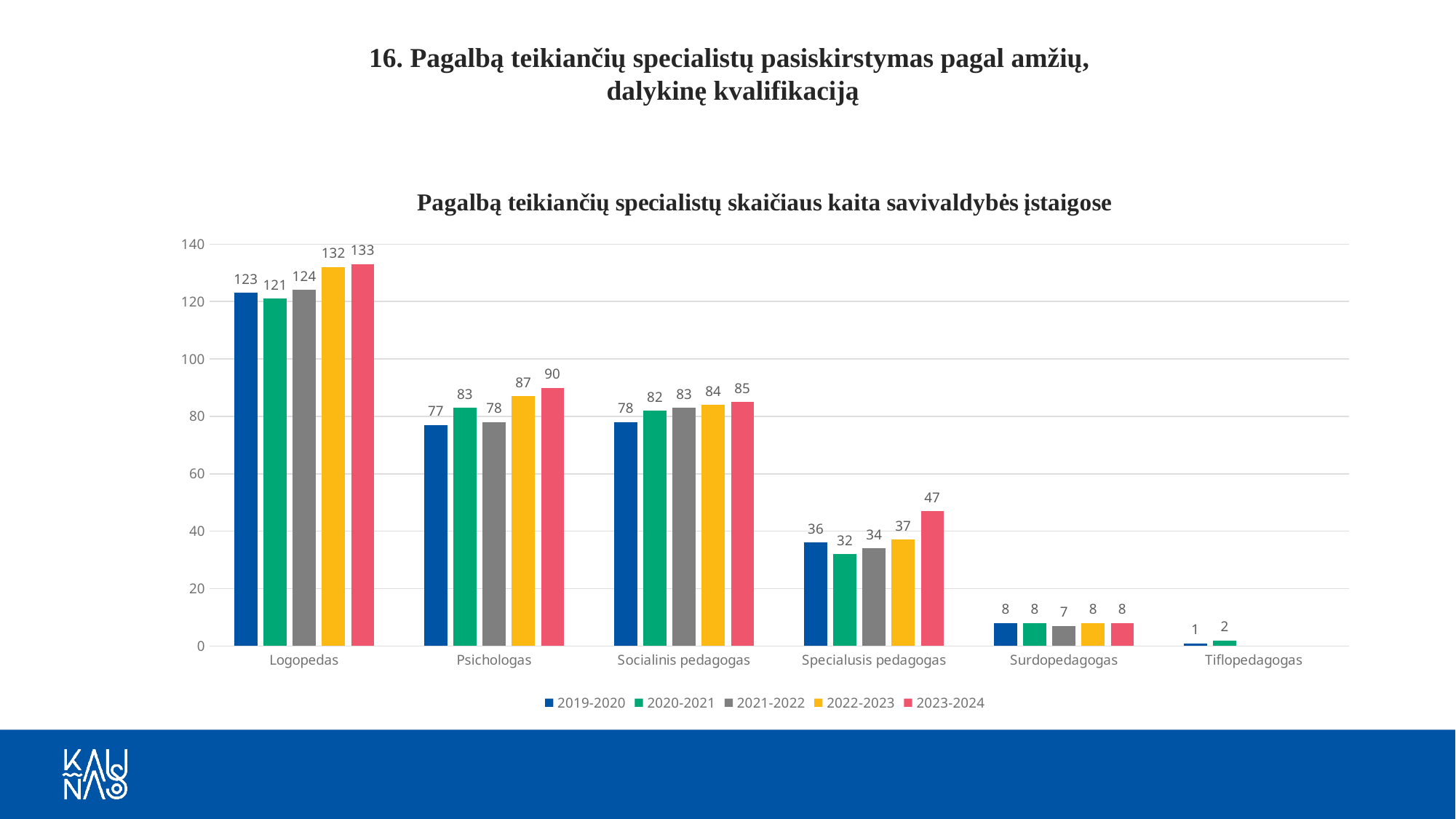
What is the difference between the 2023-2024 and 2019-2020 values for Specialusis pedagogas? 11 What kind of chart is shown on the slide? Bar chart What is the value for Logopedas in the 2023-2024 series? 133 What is the value for Specialusis pedagogas in the 2022-2023 series? 37 Do the values for Socialinis pedagogas rise or fall from 2019-2020 to 2023-2024? Rise How many series does the legend list? 5 What is the title of the chart? Pagalbą teikiančių specialistų skaičiaus kaita savivaldybės įstaigose Which category has the highest value in the 2021-2022 series? Logopedas How many categories are shown on the x axis? 6 What is the value for Psichologas in the 2019-2020 series? 77 Which category has the lowest value in the 2020-2021 series? Tiflopedagogas Which is larger for Socialinis pedagogas: the 2020-2021 value or the 2021-2022 value? 2021-2022